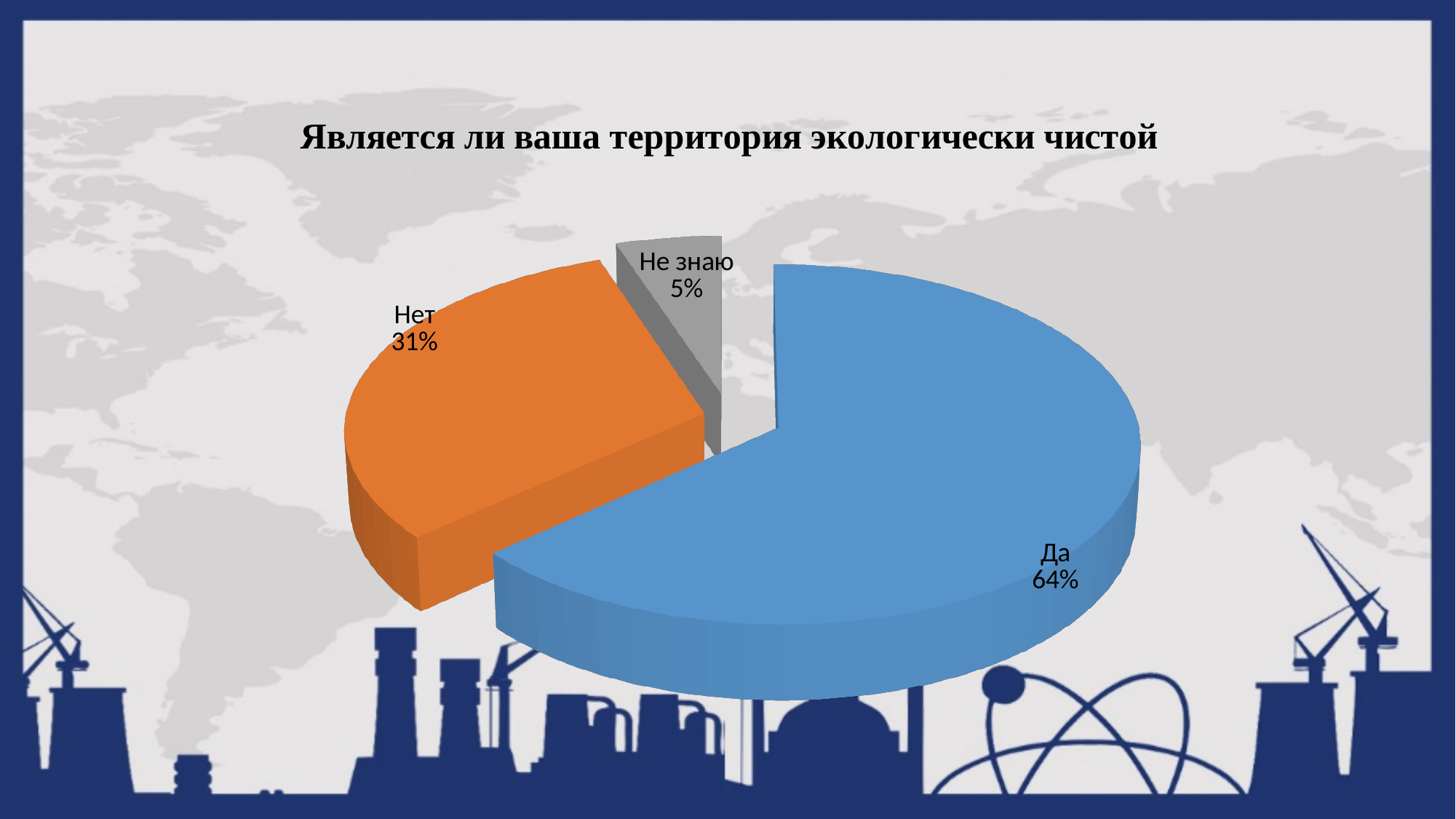
Which category has the largest slice of the pie? Да Which is larger, the "Нет" slice or the "Не знаю" slice? Нет What share of the pie does the "Нет" slice represent? 31% What is the difference in percentage points between the "Нет" and "Не знаю" slices? 26 What share of the pie does the "Да" slice represent? 64% What kind of chart is shown on the slide? Pie chart What is the difference in percentage points between the "Да" and "Нет" slices? 33 What is the title of the chart? Является ли ваша территория экологически чистой What colour is the "Да" slice? Blue Which category has the smallest slice of the pie? Не знаю What share of the pie does the "Не знаю" slice represent? 5% How many slices does the pie chart have? 3